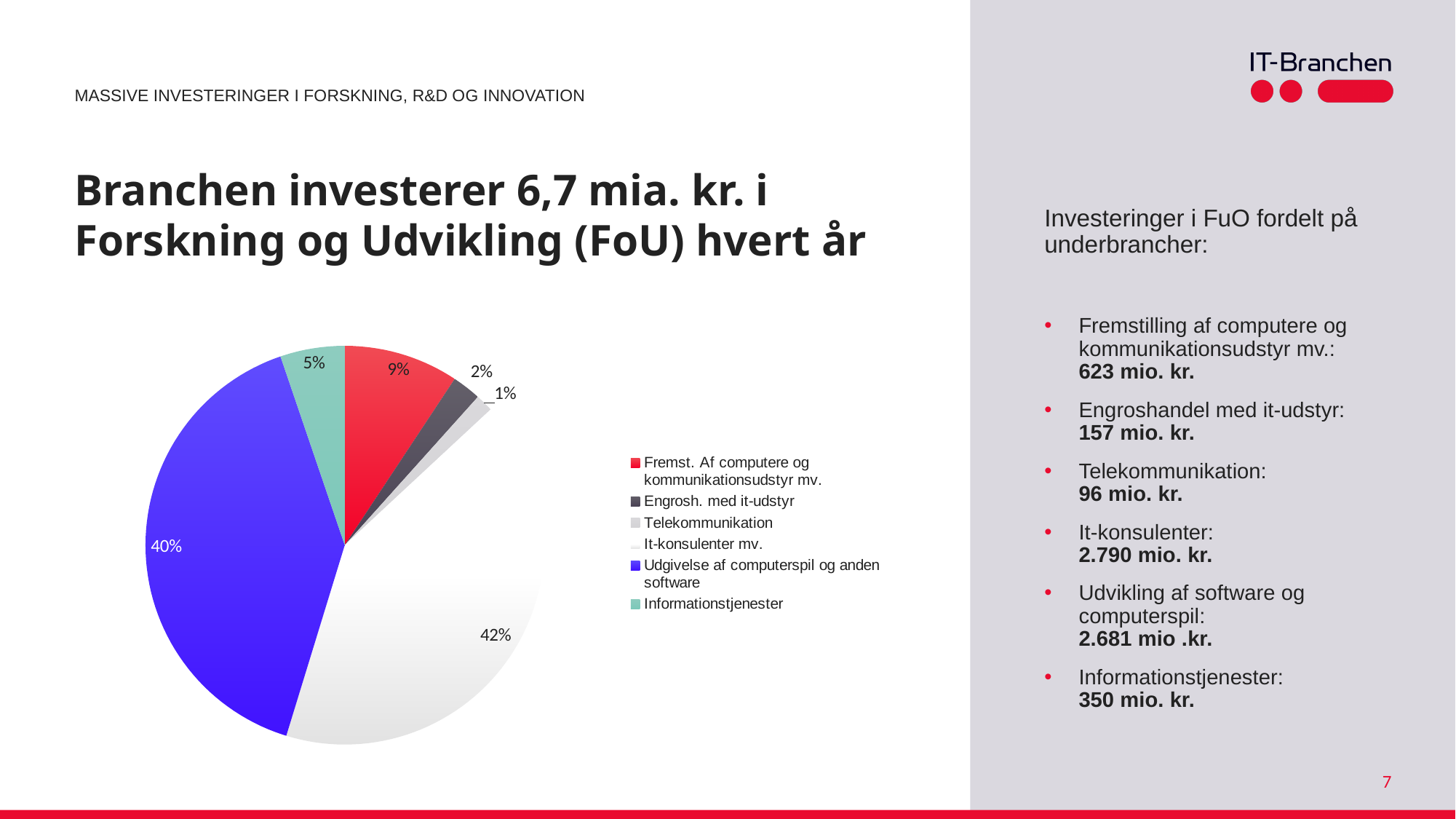
What kind of chart is shown on the slide? pie chart Which category has the smallest slice of the pie? Telekommunikation What share of the pie does It-konsulenter mv. have? 42% What share of the pie does Udgivelse af computerspil og anden software have? 40% What share of the pie does Telekommunikation have? 1% Which is larger, the slice for Engrosh. med it-udstyr or the slice for Informationstjenester? Informationstjenester What is the difference in percentage points between the Fremst. Af computere og kommunikationsudstyr mv. slice and the Informationstjenester slice? 4 percentage points Which category has the largest slice of the pie? It-konsulenter mv. How many slices does the pie chart have? 6